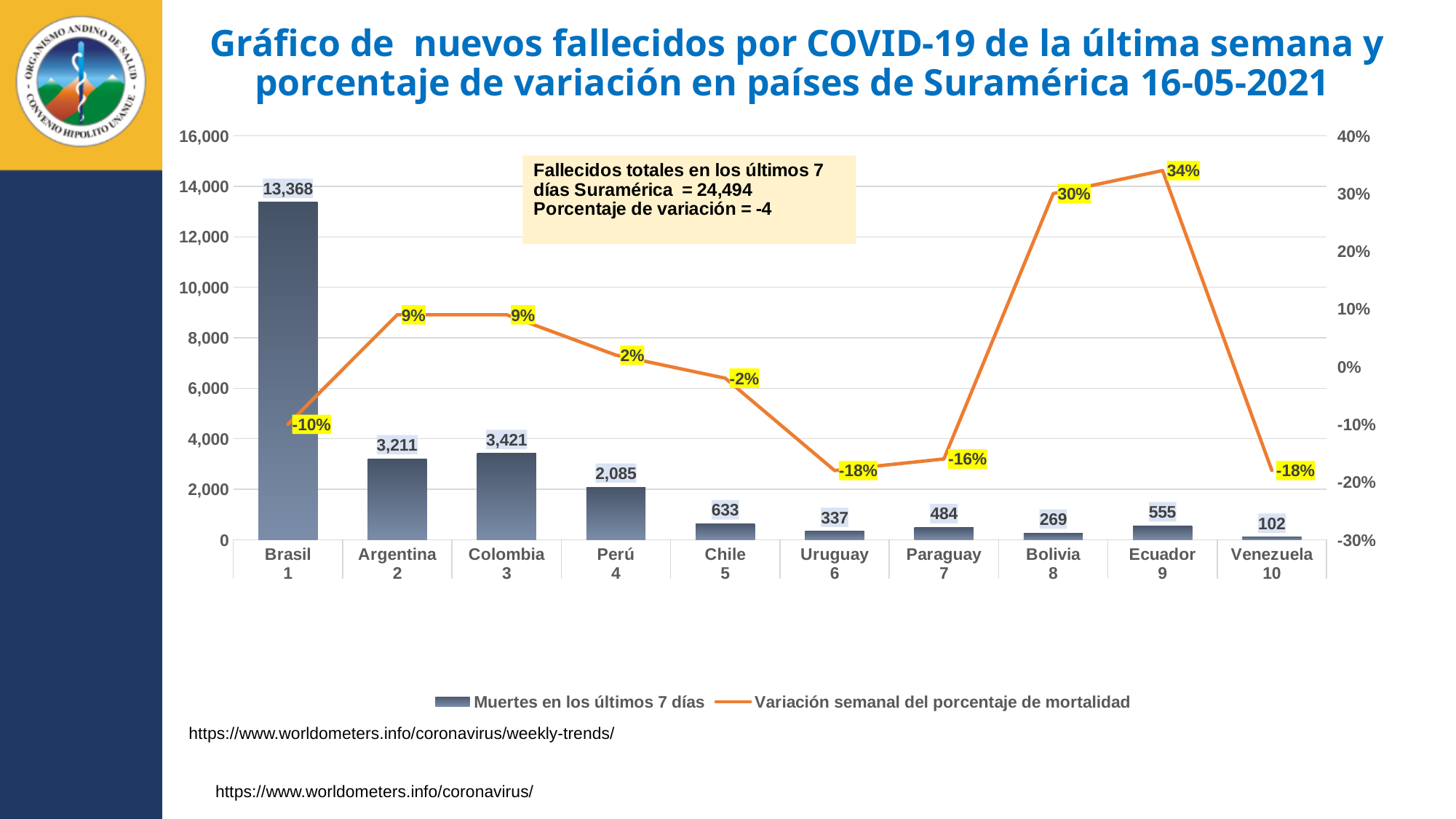
Which country has the highest number of deaths in the last 7 days? Brasil How many series does the legend list? 2 How many deaths in the last 7 days are shown for Perú? 2,085 What is the difference in deaths in the last 7 days between Colombia and Argentina? 210 What is the weekly variation percentage shown for Uruguay? -18% What kinds of chart are combined on this slide? Bar chart and line chart Which country has the lowest number of deaths in the last 7 days? Venezuela Which has more deaths in the last 7 days, Chile or Ecuador? Chile How many countries are shown on the x axis? 10 Which country has the lowest weekly variation percentage on the line? Uruguay and Venezuela (both -18%) How many deaths in the last 7 days are shown for Brasil? 13,368 What is the weekly variation percentage shown for Ecuador? 34%